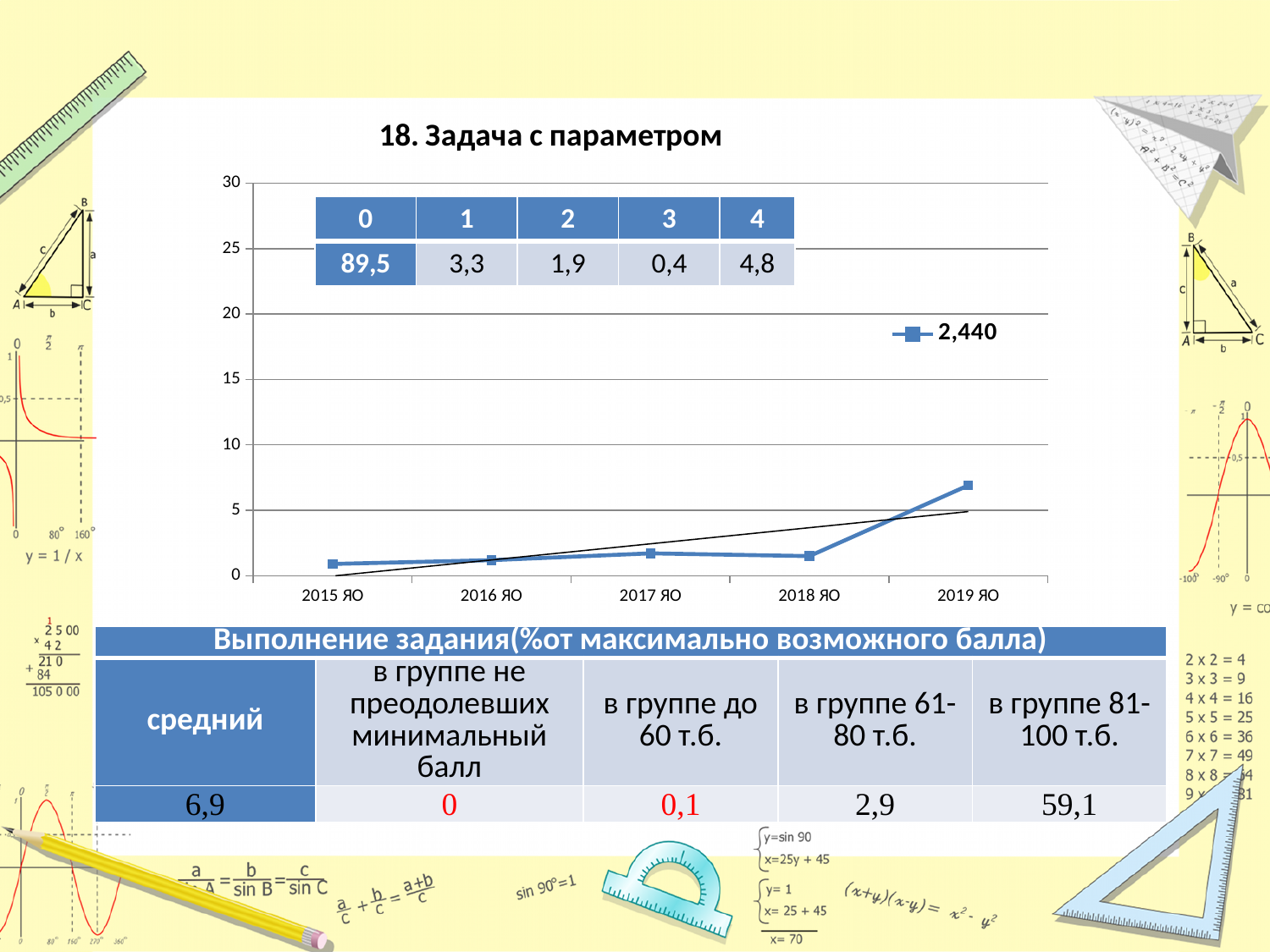
Is the value for 2015 ЯО greater or less than 5? less Do the values generally rise or fall from 2015 ЯО to 2019 ЯО? rise How many categories are shown on the x axis of the chart? 5 Is the value for 2019 ЯО greater or less than 5? greater What is the title of the chart? 18. Задача с параметром Which is larger, the value for 2019 ЯО or the value for 2018 ЯО? 2019 ЯО Which category has the highest value on the chart? 2019 ЯО What kind of chart is shown on the slide? line chart Is the value for 2018 ЯО greater or less than 10? less What is the legend entry for the plotted series? 2,440 How many series does the chart legend list? 1 What is the highest value shown on the y axis of the chart? 30